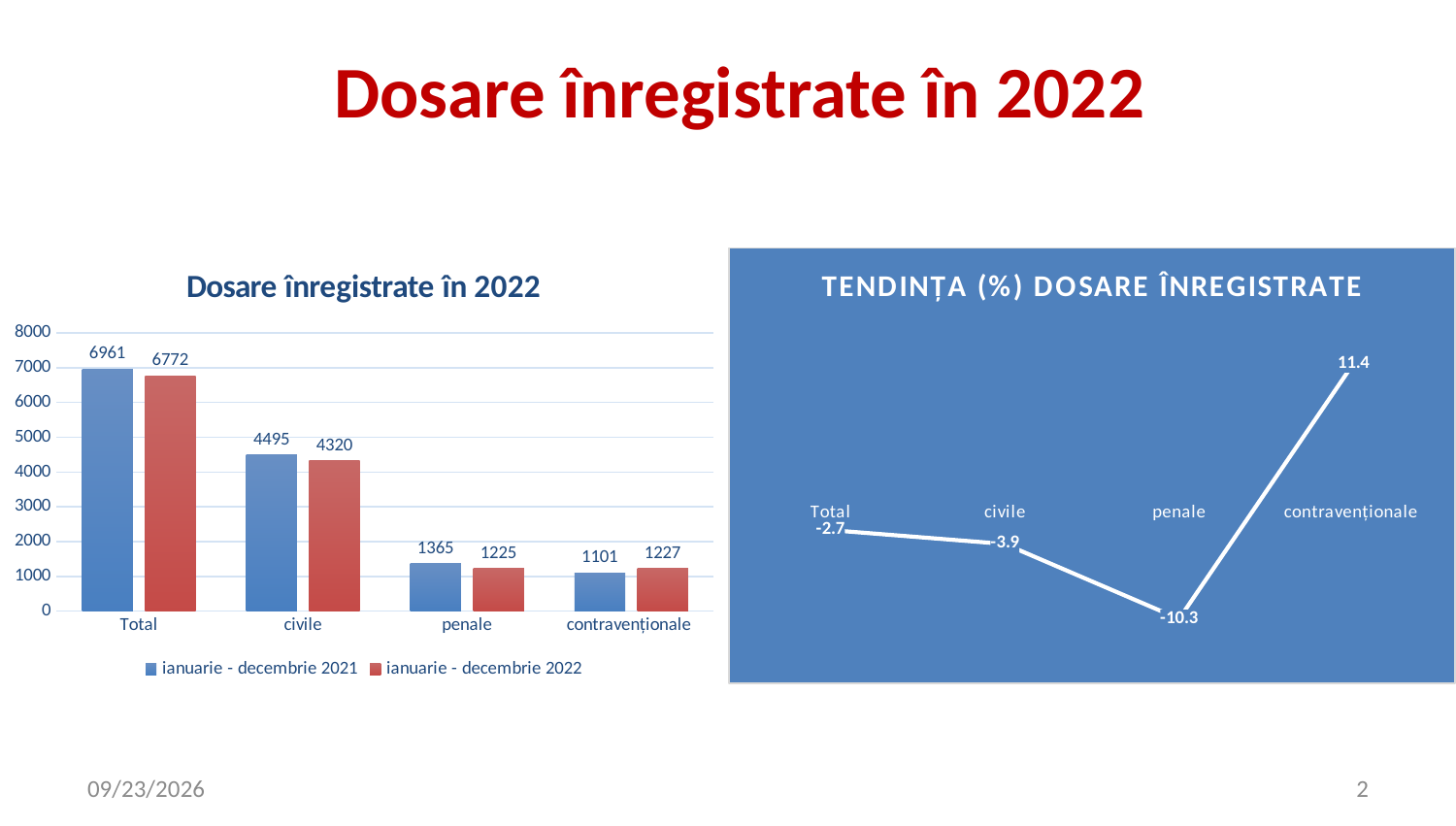
In the chart titled "Dosare înregistrate în 2022", which is larger for contravenționale: the 2021 value or the 2022 value? the 2022 value (1227) In the chart titled "Dosare înregistrate în 2022", which category has the lowest value in the series "ianuarie - decembrie 2021"? contravenționale In the chart titled "Dosare înregistrate în 2022", what is the difference between the Total values for 2021 and 2022? 189 What kind of chart is the one titled "Dosare înregistrate în 2022"? bar chart In the chart titled "TENDINȚA (%) DOSARE ÎNREGISTRATE", what is the value for penale? -10.3 In the chart titled "Dosare înregistrate în 2022", how many categories are shown on the x axis? 4 What kind of chart is the one titled "TENDINȚA (%) DOSARE ÎNREGISTRATE"? line chart In the chart titled "Dosare înregistrate în 2022", what is the value for penale in the series "ianuarie - decembrie 2021"? 1365 In the chart titled "TENDINȚA (%) DOSARE ÎNREGISTRATE", which category has the highest value? contravenționale In the chart titled "Dosare înregistrate în 2022", how many series does the legend list? 2 In the chart titled "Dosare înregistrate în 2022", what is the value for Total in the series "ianuarie - decembrie 2022"? 6772 In the chart titled "TENDINȚA (%) DOSARE ÎNREGISTRATE", what is the difference between the values for contravenționale and penale? 21.7